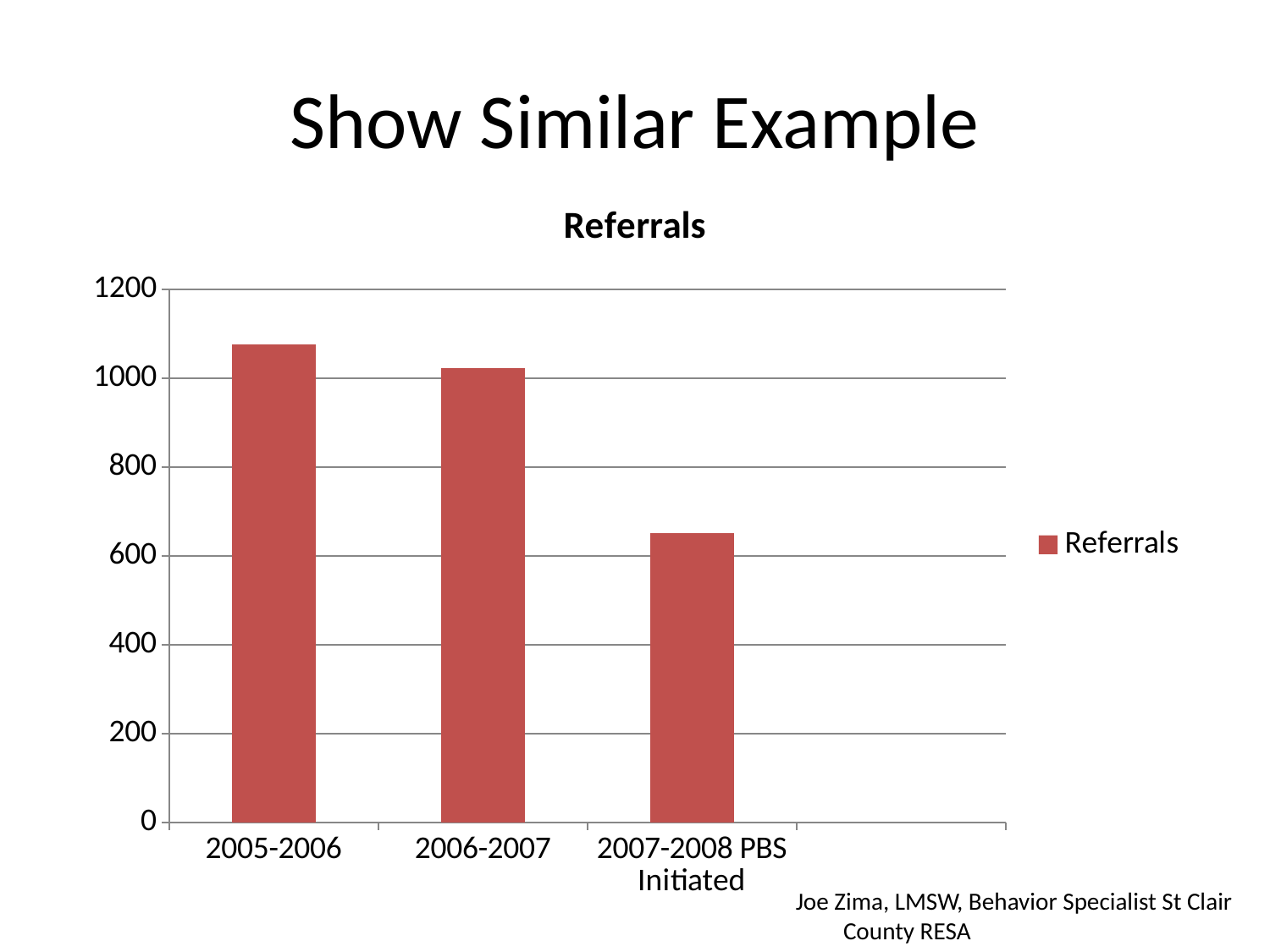
Is the value for 2007-2008 PBS Initiated greater or less than 800? less Is the value for 2007-2008 PBS Initiated greater or less than 600? greater Is the value for 2006-2007 greater or less than 1000? greater What is the title of the chart? Referrals Which category has the lowest number of referrals? 2007-2008 PBS Initiated Which category has the highest number of referrals? 2005-2006 What kind of chart is shown on the slide? bar chart Which is larger, the value for 2006-2007 or the value for 2007-2008 PBS Initiated? 2006-2007 How many categories are shown on the x axis of the chart? 3 How many series does the legend list? 1 Do the referral values rise or fall from left to right along the x axis? fall